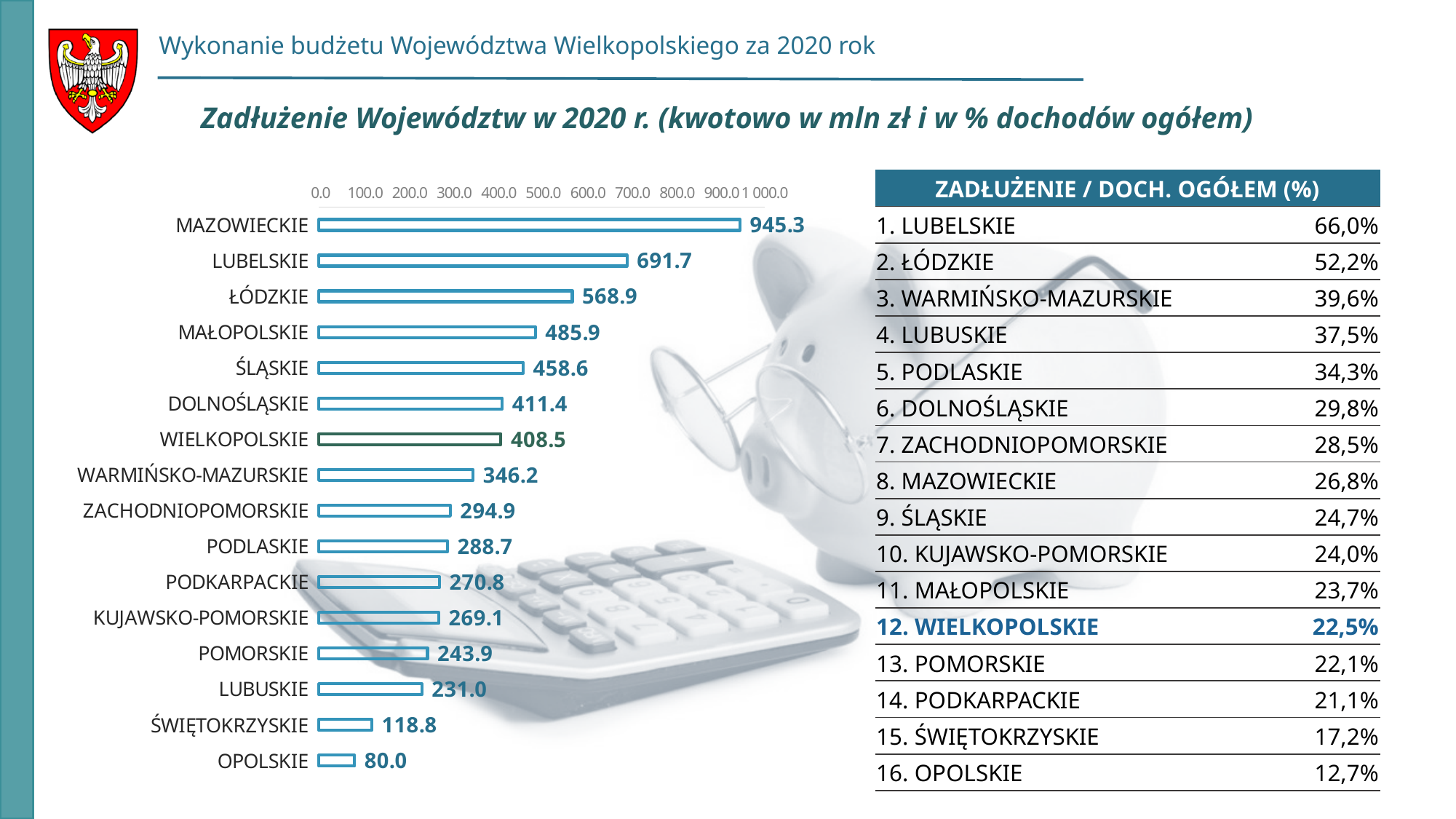
Which voivodeship has the lowest debt in the bar chart? OPOLSKIE How many voivodeships are shown in the bar chart? 16 Which bar in the chart is drawn in a different (dark green) colour from the others? WIELKOPOLSKIE Which voivodeship has the highest debt in the bar chart? MAZOWIECKIE What is the difference between the debt values of MAZOWIECKIE and LUBELSKIE in the bar chart? 253.6 Is the debt value for LUBUSKIE in the bar chart greater or less than 300.0? less What type of chart is used to show the debt of the voivodeships? bar chart What is the debt value shown for ŚWIĘTOKRZYSKIE in the bar chart? 118.8 Which has a larger debt value in the bar chart, ŁÓDZKIE or MAŁOPOLSKIE? ŁÓDZKIE What is the debt value shown for MAZOWIECKIE in the bar chart? 945.3 What is the debt value shown for WIELKOPOLSKIE in the bar chart? 408.5 What is the difference between the debt values of WIELKOPOLSKIE and OPOLSKIE in the bar chart? 328.5